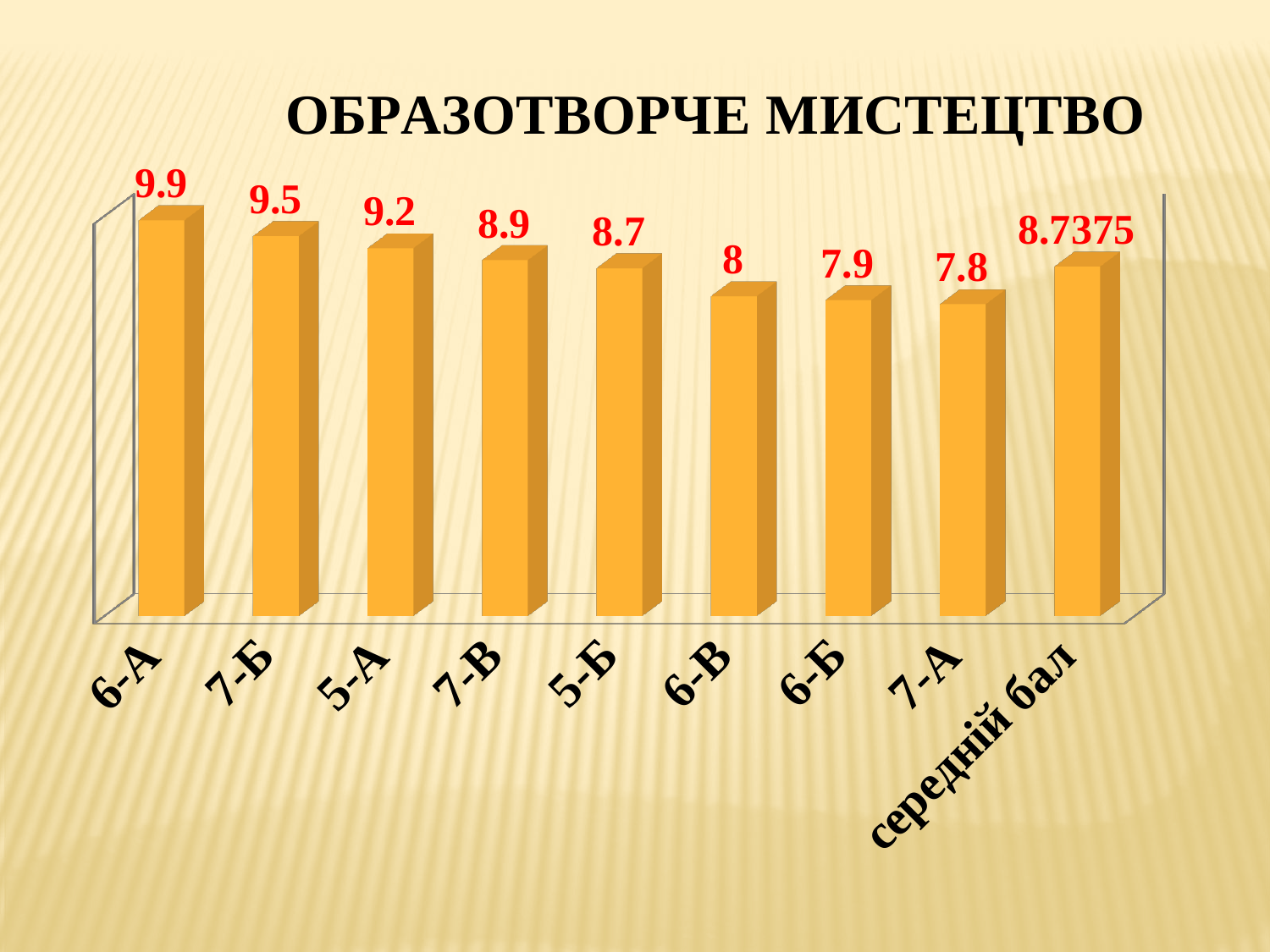
Which class has the lowest value? 7-А What is the difference between the values for 7-Б and 5-Б? 0.8 What is the value shown for середній бал? 8.7375 What is the difference between the values for 6-А and 7-А? 2.1 What is the title of the chart? ОБРАЗОТВОРЧЕ МИСТЕЦТВО Which is larger, the value for 5-А or the value for 6-В? 5-А What is the value for 7-В? 8.9 Do the class values rise or fall from 6-А to 7-А along the x axis? fall What kind of chart is shown? bar chart Which class has the highest value? 6-А How many bars are plotted on the chart? 9 What is the value for 6-А? 9.9